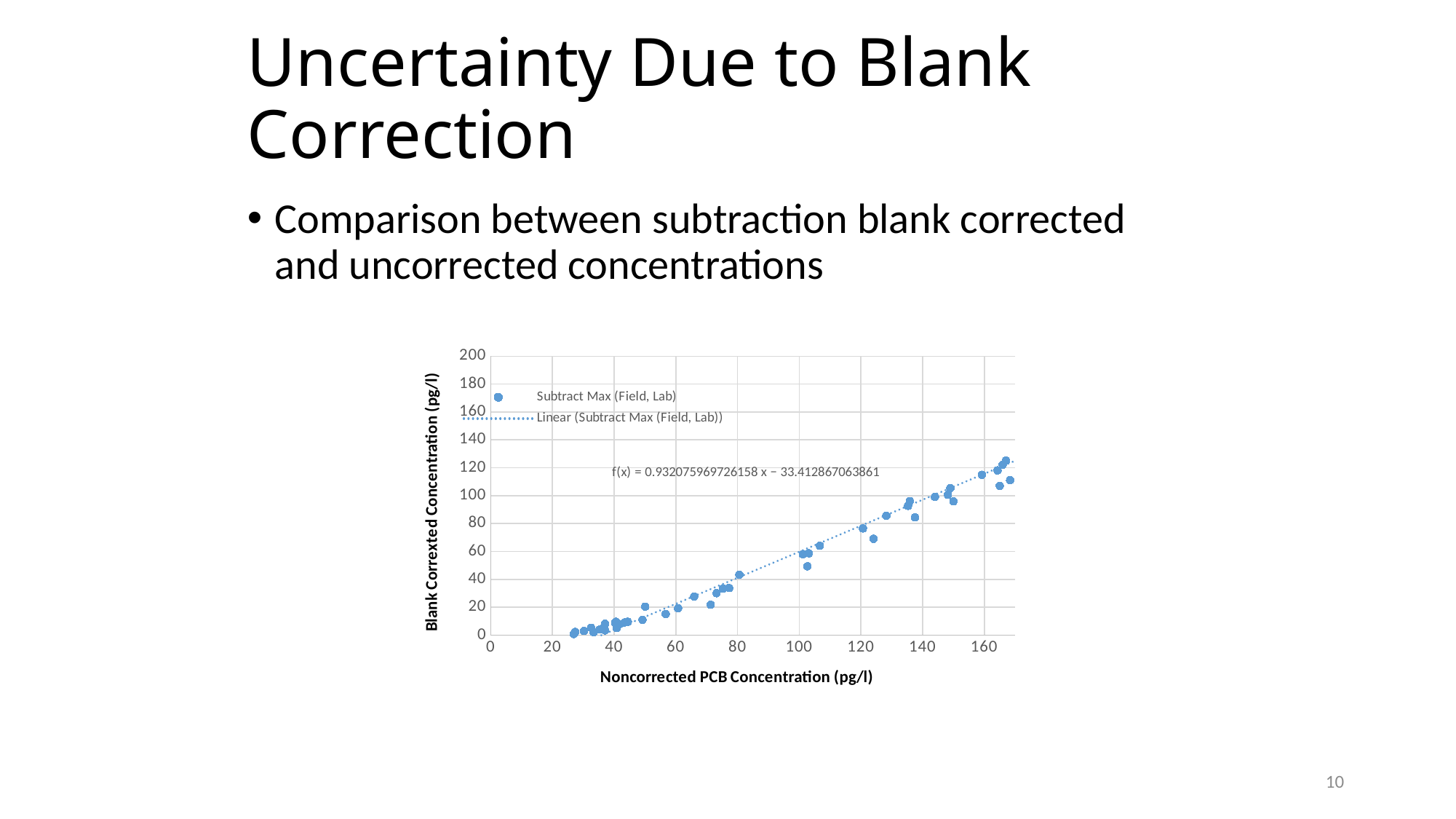
What is the maximum value shown on the y axis of the chart? 200 What is the slope of the linear trendline shown in the chart's equation? 0.932075969726158 What kind of chart is shown on the slide? scatter chart Do the plotted values rise or fall as the noncorrected PCB concentration increases along the x axis? rise How many entries does the chart legend list? 2 Is the lowest noncorrected PCB concentration plotted in the chart greater or less than 20? greater Is the highest blank corrected concentration plotted in the chart greater or less than 140? less What is the title of the x axis of the chart? Noncorrected PCB Concentration (pg/l)